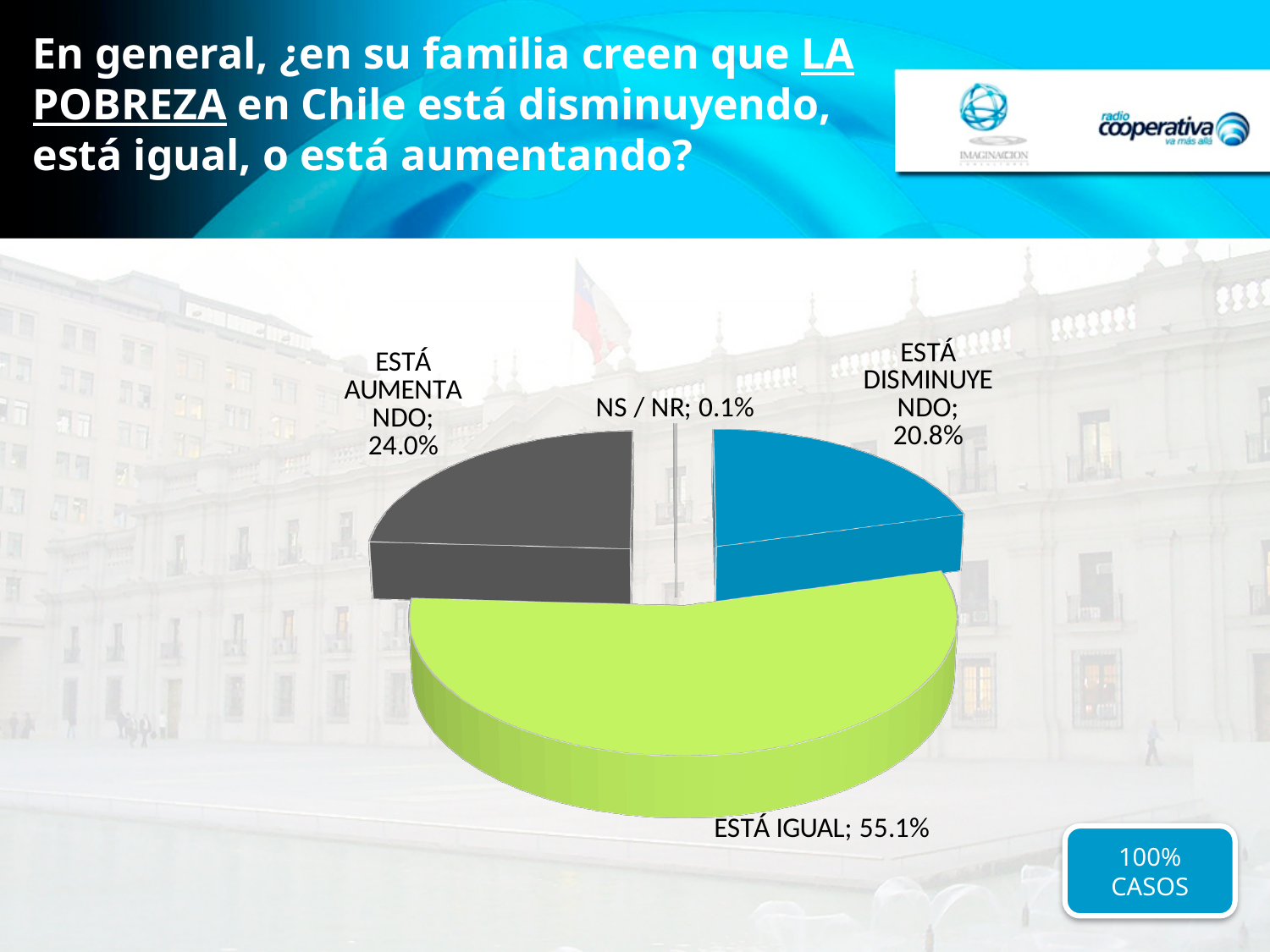
What percentage of respondents answered "ESTÁ DISMINUYENDO"? 20.8% How many slices does the pie chart have? 4 Which response category has the largest share of the pie? ESTÁ IGUAL What is the difference in percentage points between "ESTÁ IGUAL" and "ESTÁ AUMENTANDO"? 31.1 What percentage of respondents answered "ESTÁ AUMENTANDO"? 24.0% What percentage of respondents answered "ESTÁ IGUAL"? 55.1% Which is larger, the share for "ESTÁ AUMENTANDO" or the share for "ESTÁ DISMINUYENDO"? ESTÁ AUMENTANDO What colour is the slice for "ESTÁ IGUAL"? Green What percentage is shown for "NS / NR"? 0.1% What kind of chart is shown on the slide? Pie chart Which response category has the smallest share of the pie? NS / NR What is the difference in percentage points between "ESTÁ AUMENTANDO" and "ESTÁ DISMINUYENDO"? 3.2